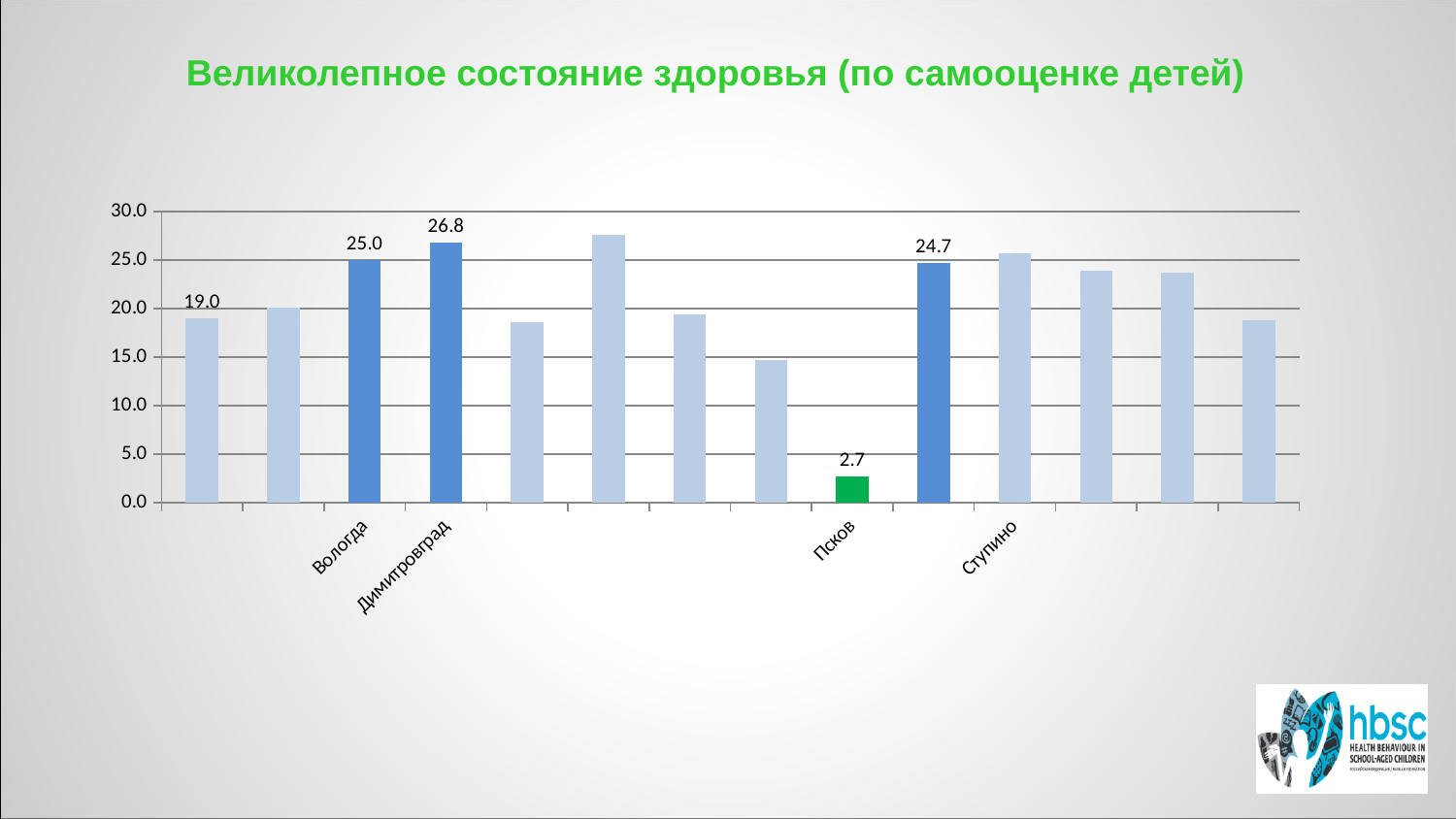
How many bars are plotted in the chart? 14 Is the value for Псков greater or less than 5.0? less What is the value for Вологда? 25.0 What type of chart is shown on the slide? Bar chart What is the value for Димитровград? 26.8 Which category has the lowest value in the chart? Псков Among Вологда, Димитровград, Псков and Ступино, which has the highest value? Димитровград What is the value for Псков? 2.7 What is the difference between the values for Димитровград and Псков? 24.1 What is the difference between the values for Димитровград and Вологда? 1.8